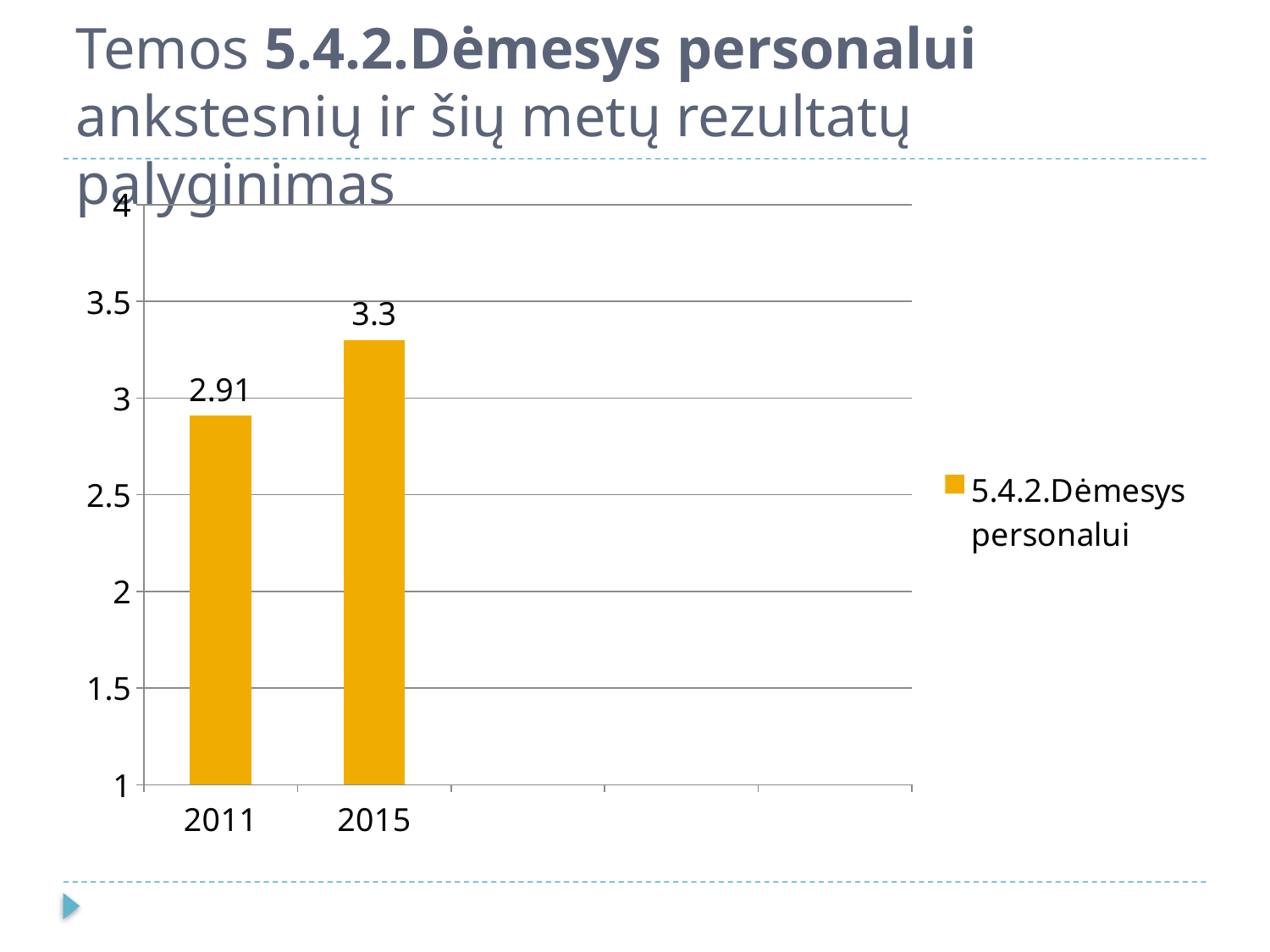
What kind of chart is shown on the slide? Bar chart Is the value for 2015 greater or less than 3.5? less What is the name of the series shown in the legend? 5.4.2.Dėmesys personalui Which year has the higher value? 2015 Is the value for 2011 greater or less than 3? less Is the value for 2015 larger than the value for 2011? Yes What is the value for 2015? 3.3 What is the value for 2011? 2.91 How many bars are plotted in the chart? 2 What is the difference between the 2015 and 2011 values? 0.39 Which year has the lower value? 2011 How many series does the legend list? 1